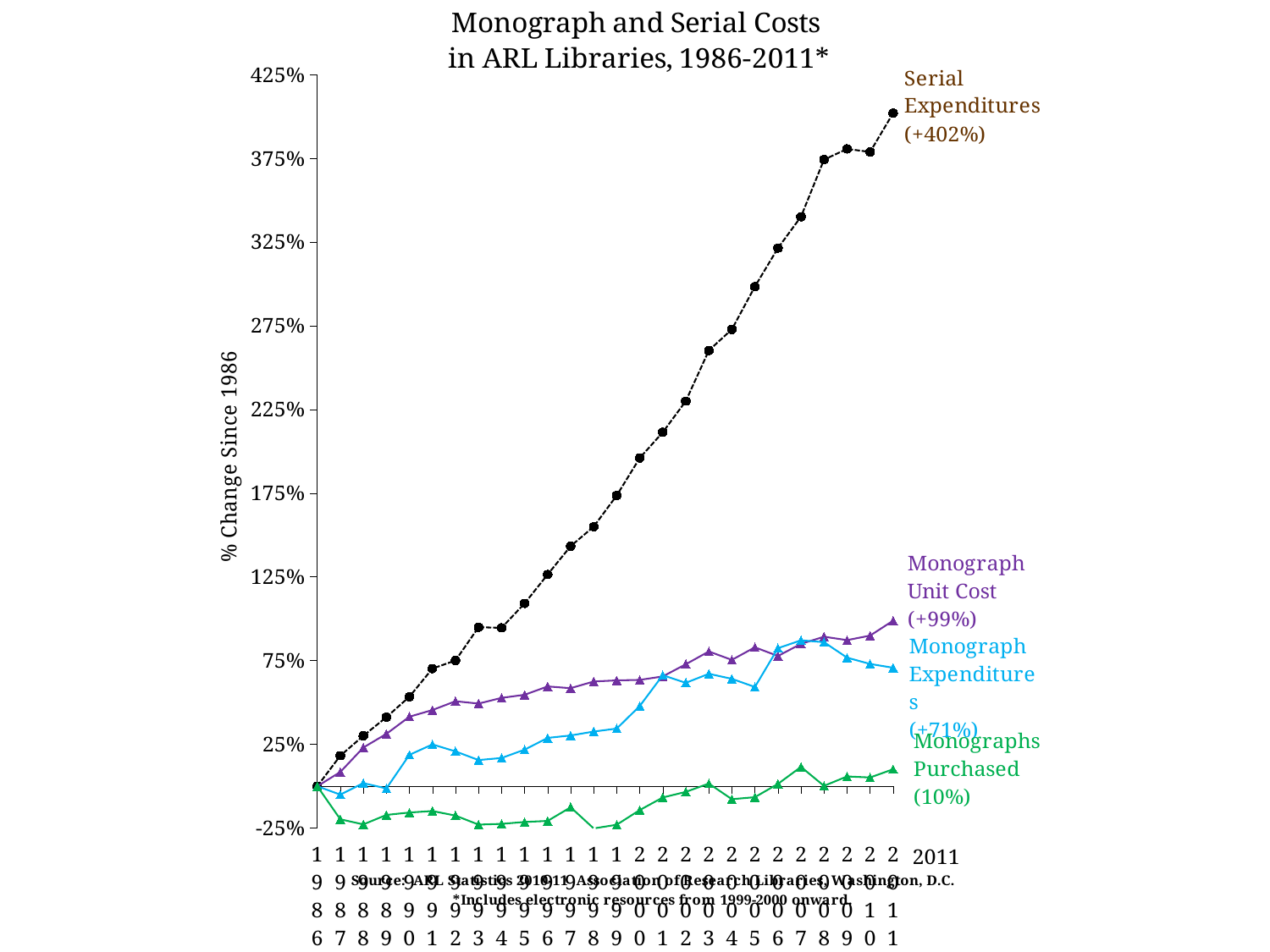
Which series has the highest value in 2011? Serial Expenditures What is the percent change since 1986 for Monographs Purchased in 2011? 10% How many series are plotted on the chart? 4 Is the value for Monograph Unit Cost in 2000 greater or less than 75%? less In 2011, which is larger: Monograph Unit Cost or Monograph Expenditures? Monograph Unit Cost Which series has the lowest value in 2011? Monographs Purchased What is the percent change since 1986 for Serial Expenditures in 2011? +402% What is the percent change since 1986 for Monograph Unit Cost in 2011? +99% Is the value for Serial Expenditures in 2005 greater or less than 275%? greater What is the label of the vertical axis? % Change Since 1986 What is the difference between the 2011 values for Serial Expenditures (+402%) and Monograph Unit Cost (+99%)? 303 percentage points What type of chart is shown on the slide? Line chart